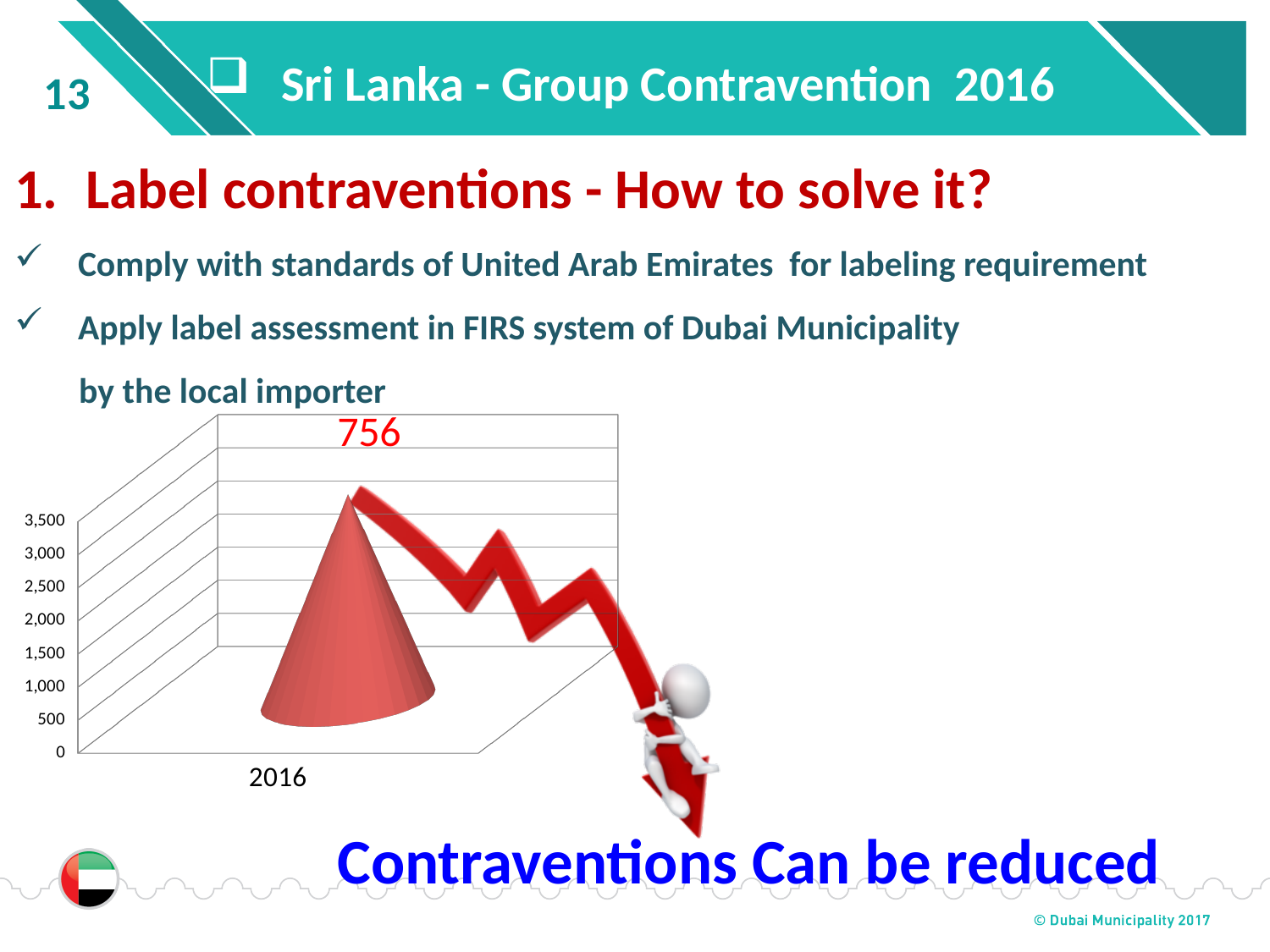
What colour is the bar plotted on the chart? red What kind of chart is shown on the slide? bar chart Is the value for 2016 greater or less than 1,000? greater What is the highest value labelled on the vertical axis of the chart? 3,500 How many categories are plotted on the chart? 1 Is the value for 2016 greater or less than 500? greater